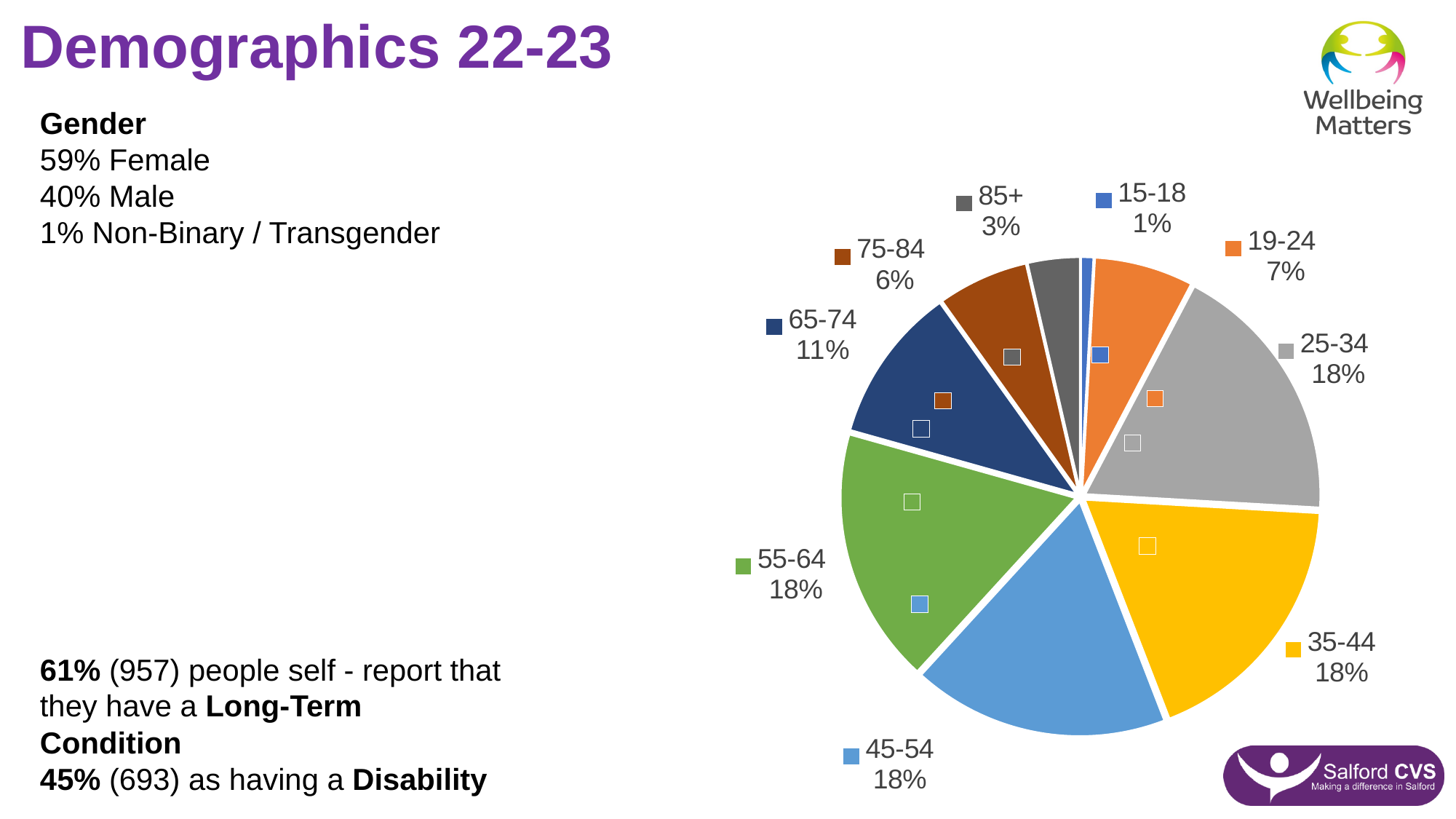
What share of the pie does the 65-74 age group have? 11% Which is larger, the share for 65-74 or the share for 55-64? 55-64 What is the value shown for the 75-84 age group? 6% What is the value shown for the 19-24 age group? 7% Which age group has the smallest share of the pie? 15-18 What is the value shown for the 85+ age group? 3% What kind of chart is shown on the slide? pie chart Which is larger, the share for 19-24 or the share for 85+? 19-24 How many age groups are shown in the pie chart? 9 What is the difference between the shares of the 25-34 and 19-24 age groups? 11% What is the difference between the shares of the 65-74 and 75-84 age groups? 5% What is the combined share of the 15-18 and 19-24 age groups? 8%